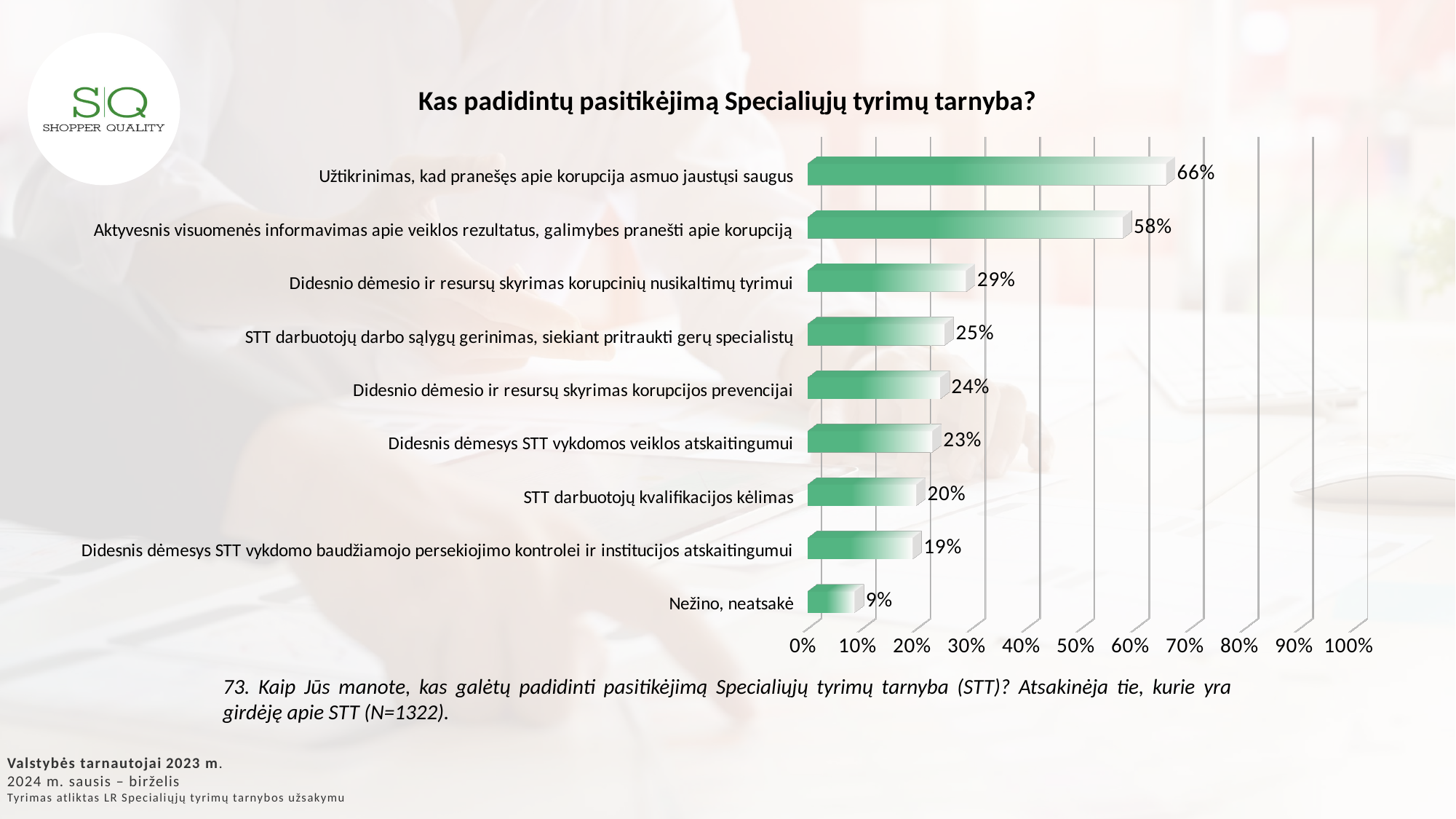
What kind of chart is shown on the slide? bar chart What is the value for "Didesnis dėmesys STT vykdomo baudžiamojo persekiojimo kontrolei ir institucijos atskaitingumui"? 19% What is the value for "STT darbuotojų kvalifikacijos kėlimas"? 20% What is the title of the chart? Kas padidintų pasitikėjimą Specialiųjų tyrimų tarnyba? Which category has the highest value? Užtikrinimas, kad pranešęs apie korupcija asmuo jaustųsi saugus Is the value for "Aktyvesnis visuomenės informavimas apie veiklos rezultatus, galimybes pranešti apie korupciją" greater or less than 50%? greater What is the value for "Užtikrinimas, kad pranešęs apie korupcija asmuo jaustųsi saugus"? 66% Which category has the lowest value? Nežino, neatsakė Which is larger: the value for "Didesnio dėmesio ir resursų skyrimas korupcinių nusikaltimų tyrimui" or for "STT darbuotojų darbo sąlygų gerinimas, siekiant pritraukti gerų specialistų"? Didesnio dėmesio ir resursų skyrimas korupcinių nusikaltimų tyrimui What is the value for "Nežino, neatsakė"? 9% What is the difference between the values for "Užtikrinimas, kad pranešęs apie korupcija asmuo jaustųsi saugus" and "Aktyvesnis visuomenės informavimas apie veiklos rezultatus, galimybes pranešti apie korupciją"? 8% How many categories are shown in the chart? 9